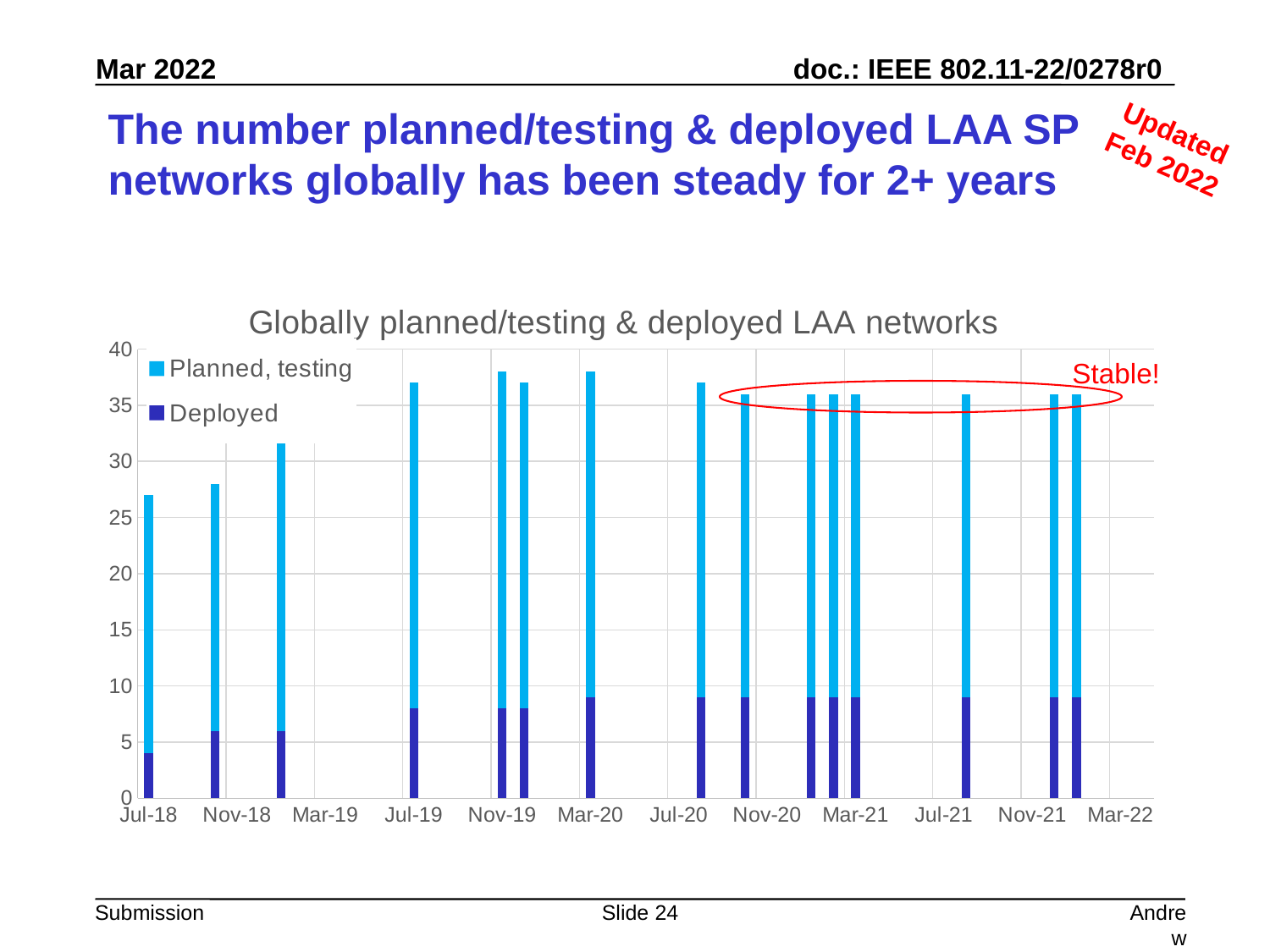
How many series does the chart legend list? 2 How many bars are plotted in the chart? 15 Is the Deployed value of the bar at Jul-19 greater or less than 10? less What is the title of the chart? Globally planned/testing & deployed LAA networks What kind of chart is shown on the slide? Stacked bar chart Is the total height of the bar at Jul-19 greater or less than 35? greater Is the total height of the bar at Jul-18 greater or less than 30? less Which bar has the lowest total, the one at Jul-18 or the one at Jul-19? Jul-18 Which bar has the lowest total in the chart? Jul-18 What are the two series named in the chart legend? Planned, testing; Deployed